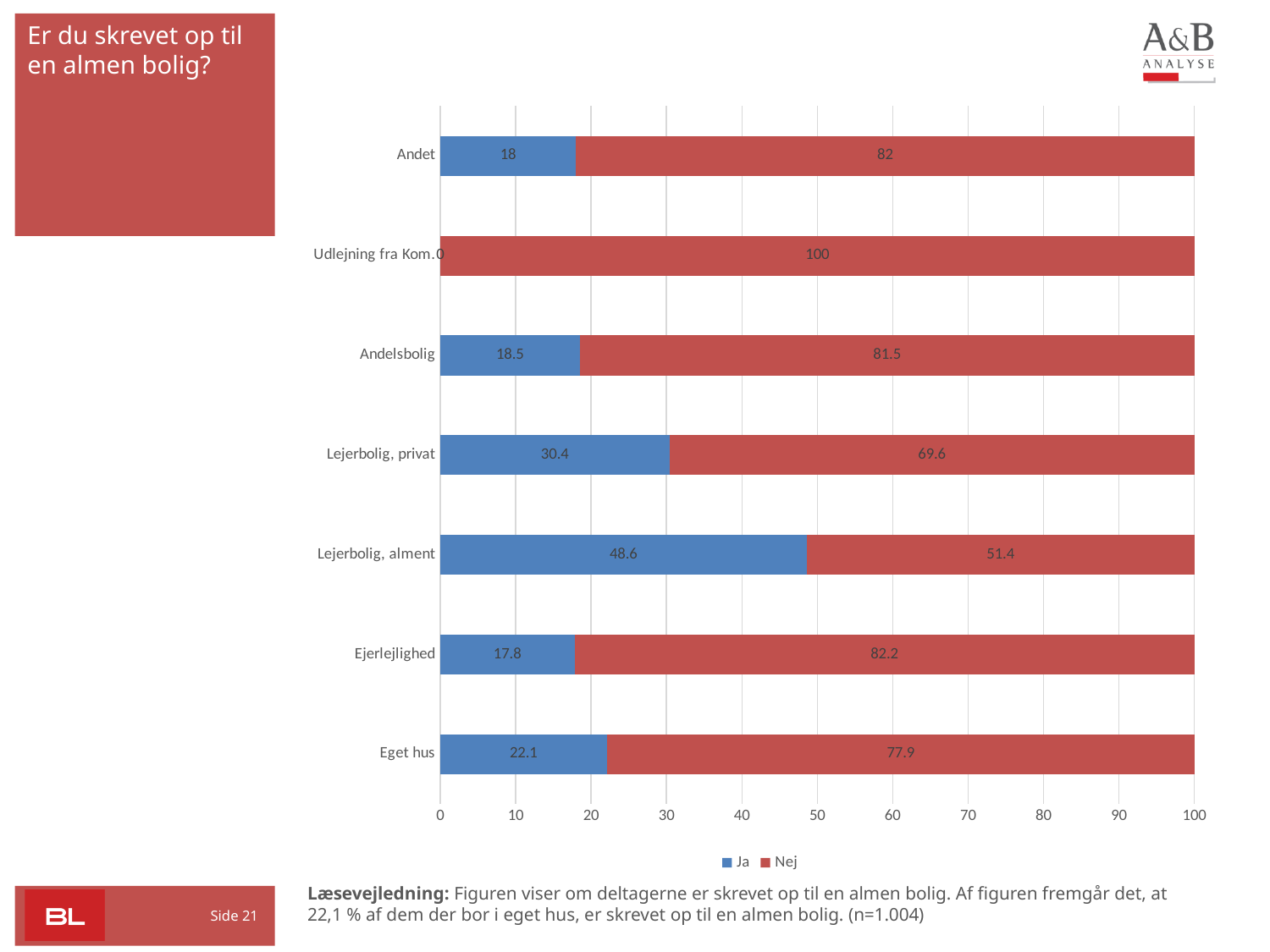
What is the 'Ja' value for Eget hus? 22.1 How many categories are shown on the y axis? 7 How many series does the legend list? 2 What is the 'Nej' value for Udlejning fra Kom.? 100 What is the difference between the 'Nej' and 'Ja' values for Ejerlejlighed? 64.4 Which category has the highest 'Ja' value? Lejerbolig, alment What kind of chart is shown on the slide? Stacked bar chart What is the 'Ja' value for Lejerbolig, alment? 48.6 Which category has the lowest 'Ja' value? Udlejning fra Kom. What is the total of the stacked bar for Andelsbolig? 100 Which is larger, the 'Ja' value for Lejerbolig, privat or the 'Ja' value for Andelsbolig? Lejerbolig, privat What is the 'Nej' value for Lejerbolig, privat? 69.6